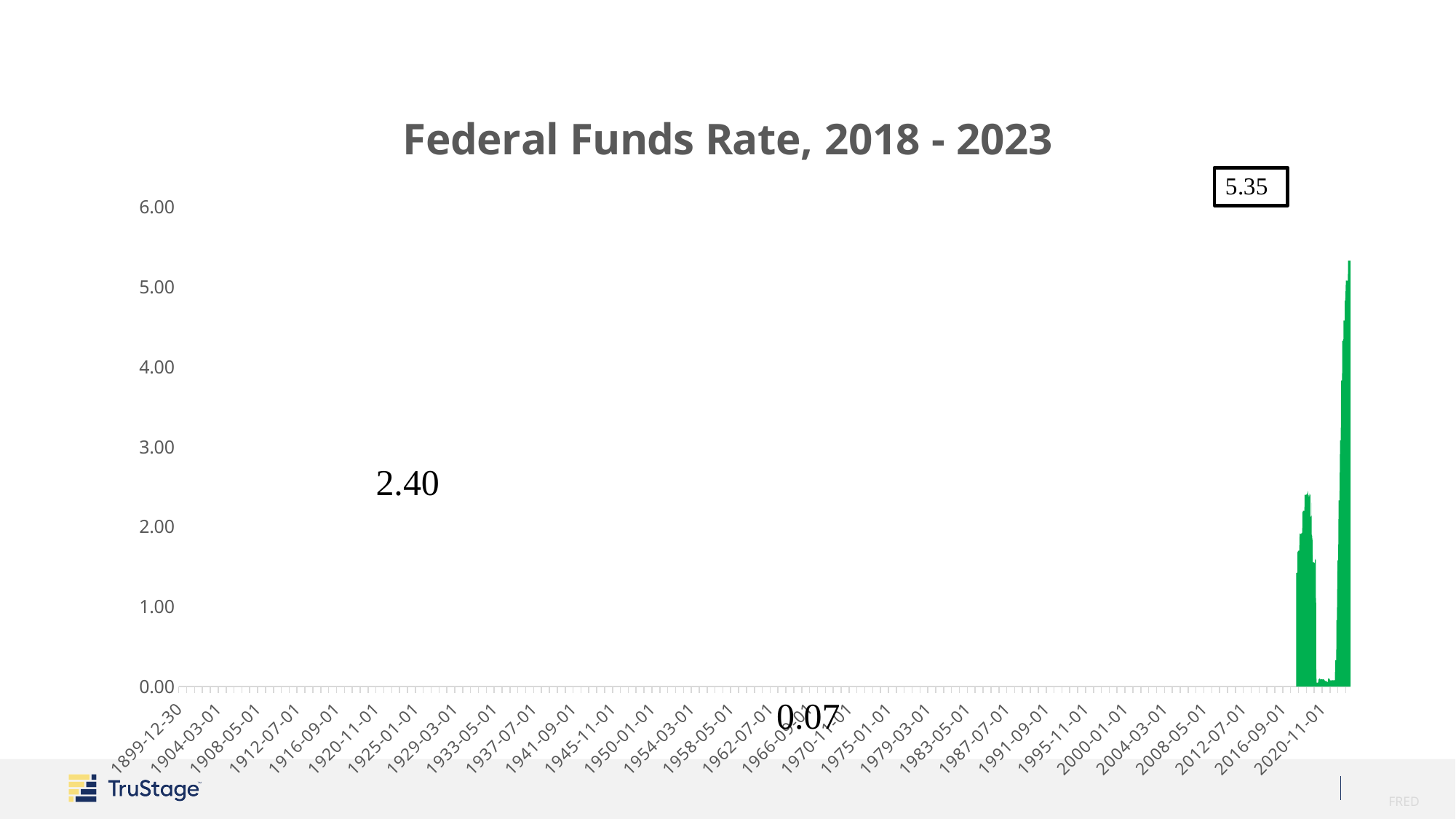
How many data values are labelled on the chart? 3 What is the lowest value labelled on the chart? 0.07 What is the difference between the labelled values 5.35 and 2.40? 2.95 Is the earlier peak of the Federal Funds Rate greater or less than 3.00? less What value is shown in the boxed label near the top right of the chart? 5.35 What is the highest value labelled on the chart? 5.35 Which labelled value is larger, 5.35 or 2.40? 5.35 What is the title of the chart? Federal Funds Rate, 2018 - 2023 What is the difference between the labelled values 5.35 and 0.07? 5.28 What value is labelled for the earlier peak of the Federal Funds Rate on the chart? 2.40 Is the highest point of the Federal Funds Rate greater or less than 5.00? greater What colour is the plotted data on the chart? Green